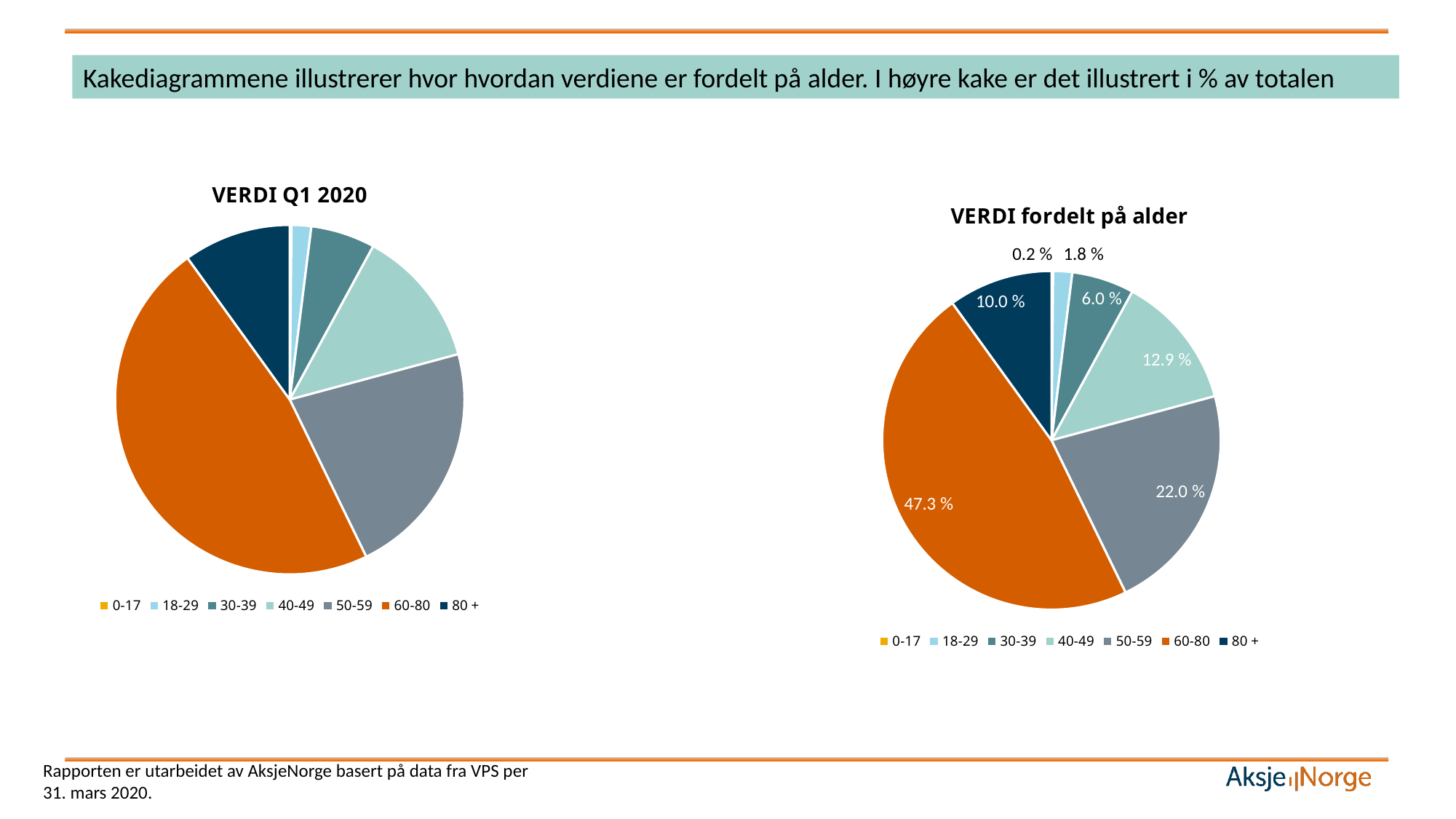
What type of chart is the chart titled "VERDI Q1 2020"? Pie chart In the chart titled "VERDI Q1 2020", which slice is larger: 40-49 or 80 +? 40-49 What is the title of the chart on the right side of the slide? VERDI fordelt på alder In the chart titled "VERDI fordelt på alder", what share is shown for the 40-49 age group? 12.9 % In the chart titled "VERDI fordelt på alder", which age group has the smallest share? 0-17 In the chart titled "VERDI fordelt på alder", which age group has the largest share? 60-80 In the chart titled "VERDI fordelt på alder", what share is shown for the 60-80 age group? 47.3 % In the chart titled "VERDI fordelt på alder", what share is shown for the 50-59 age group? 22.0 % In the chart titled "VERDI fordelt på alder", what share is shown for the 30-39 age group? 6.0 % How many entries does the legend of the chart titled "VERDI Q1 2020" list? 7 In the chart titled "VERDI fordelt på alder", what share is shown for the 80 + age group? 10.0 % In the chart titled "VERDI fordelt på alder", what is the difference between the shares of the 60-80 and 50-59 age groups? 25.3 %